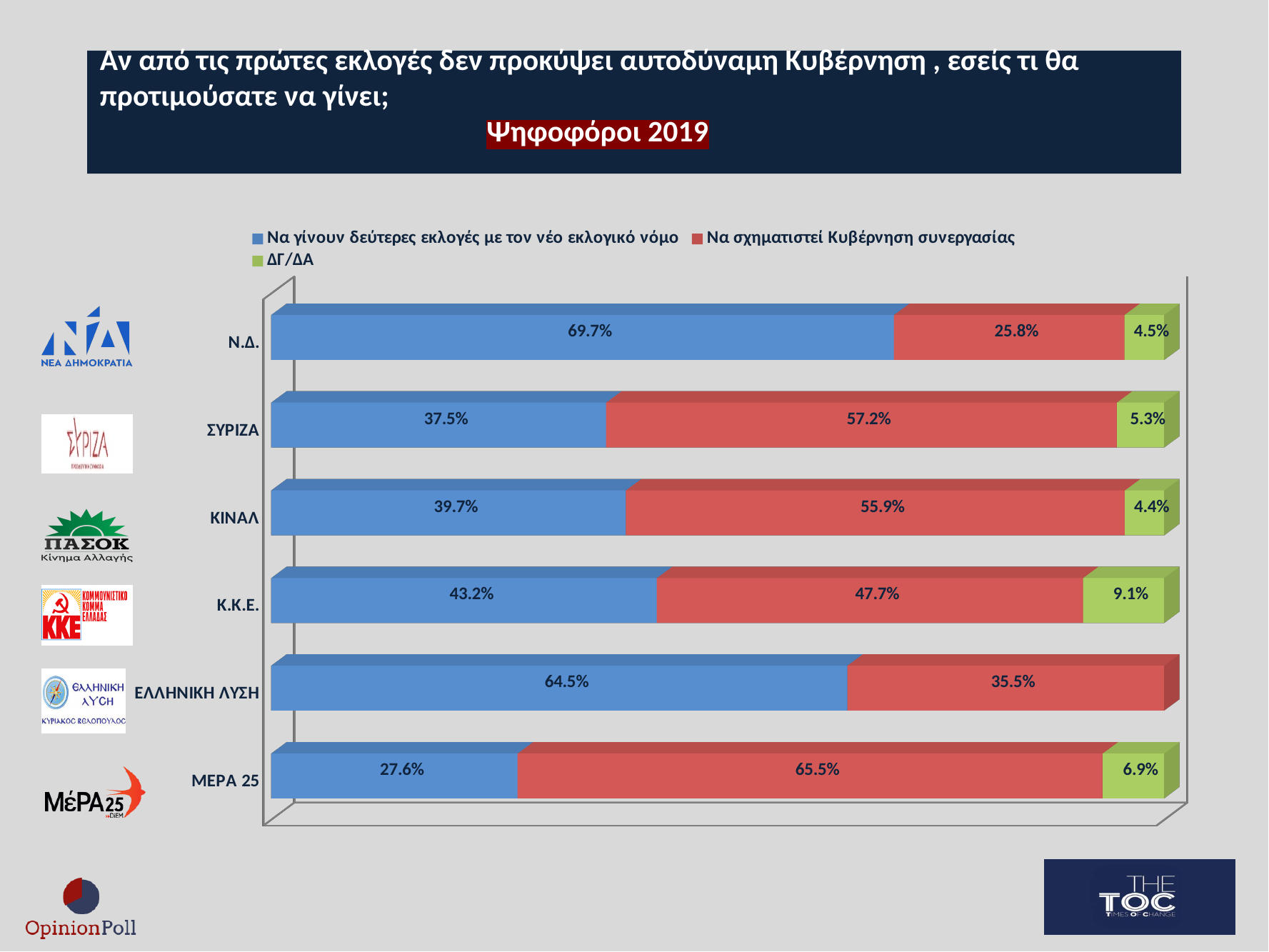
What percentage of ΣΥΡΙΖΑ voters prefer a coalition government (Να σχηματιστεί Κυβέρνηση συνεργασίας)? 57.2% How many parties (categories) are shown in the chart? 6 Which is larger: the ΚΙΝΑΛ value for second elections with the new electoral law or the ΣΥΡΙΖΑ value for the same option? ΚΙΝΑΛ Which party's voters have the highest share preferring a coalition government (Να σχηματιστεί Κυβέρνηση συνεργασίας)? ΜΕΡΑ 25 What kind of chart is shown on the slide? Stacked bar chart What is the difference between the Ν.Δ. and ΕΛΛΗΝΙΚΗ ΛΥΣΗ values for second elections with the new electoral law? 5.2% What is the total of the ΕΛΛΗΝΙΚΗ ΛΥΣΗ bar (sum of its labelled segments)? 100% What percentage of Ν.Δ. voters prefer second elections with the new electoral law (Να γίνουν δεύτερες εκλογές με τον νέο εκλογικό νόμο)? 69.7% Which party's voters have the lowest share preferring second elections with the new electoral law? ΜΕΡΑ 25 How many series does the legend list? 3 What is the ΔΓ/ΔΑ value for Κ.Κ.Ε. voters? 9.1% Which colour represents the ΔΓ/ΔΑ series in the chart? Green